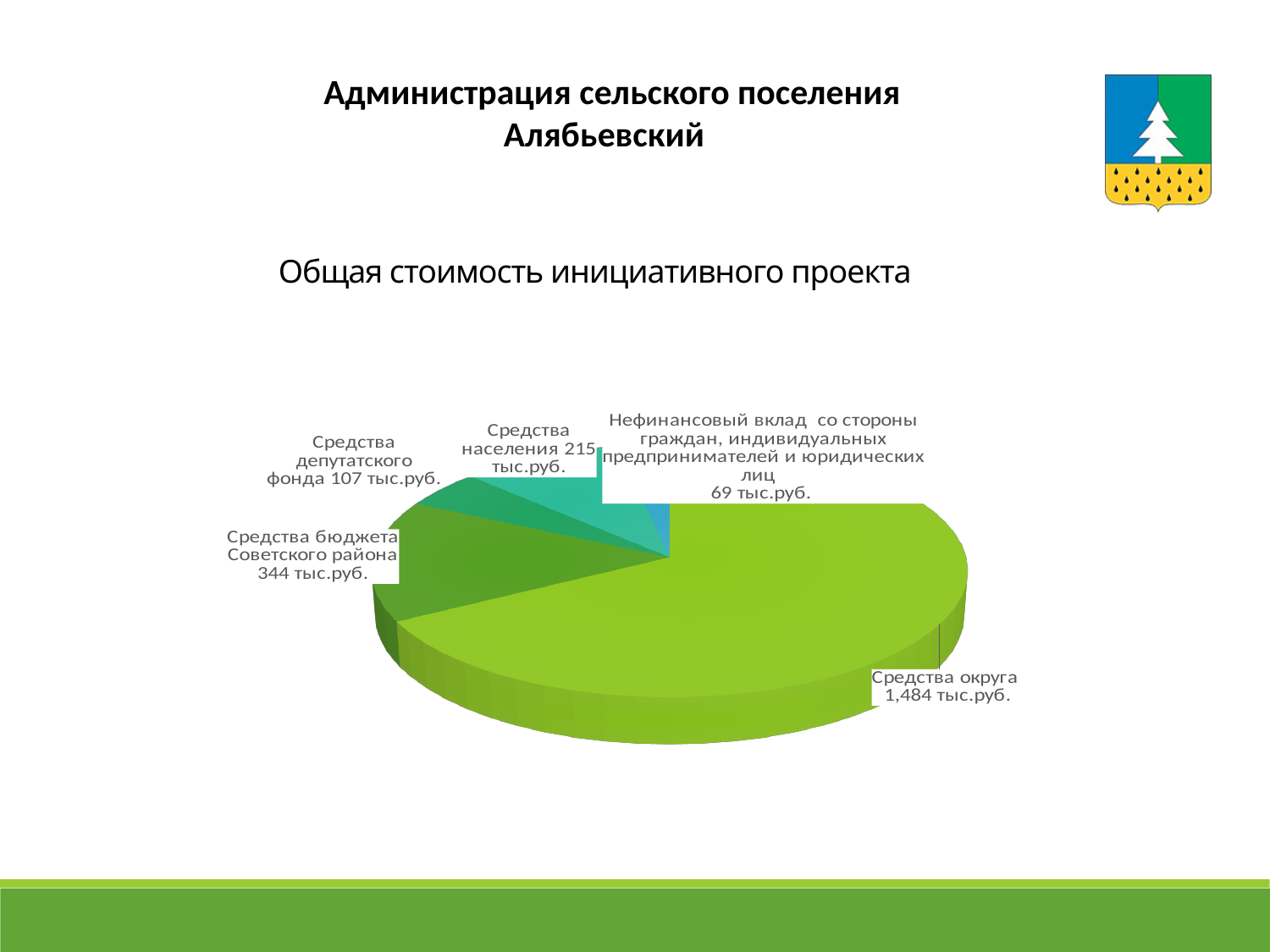
Which slice is the largest? Средства округа What is the title of the chart? Общая стоимость инициативного проекта What is the value for Средства округа? 1,484 тыс.руб. How many slices does the pie chart have? 5 Which is larger: Средства населения or Средства депутатского фонда? Средства населения What is the difference between Средства бюджета Советского района and Средства населения? 129 тыс.руб. What kind of chart is shown on the slide? Pie chart What is the value for Средства населения? 215 тыс.руб. Which slice is the smallest? Нефинансовый вклад со стороны граждан, индивидуальных предпринимателей и юридических лиц What is the value for Нефинансовый вклад со стороны граждан, индивидуальных предпринимателей и юридических лиц? 69 тыс.руб. What is the value for Средства бюджета Советского района? 344 тыс.руб. What is the value for Средства депутатского фонда? 107 тыс.руб.